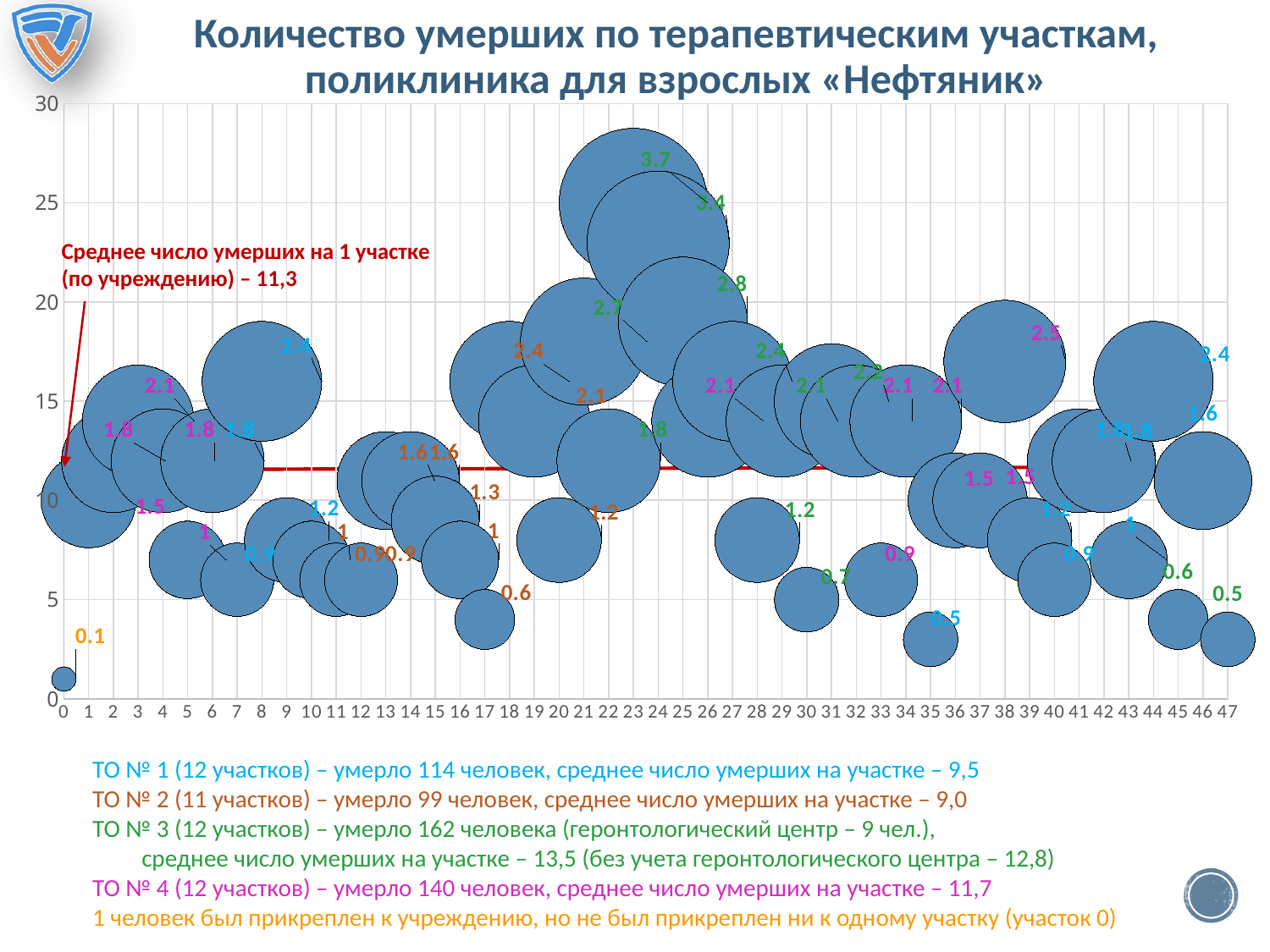
What is the difference between the largest bubble label (3.7) and the smallest bubble label (0.1)? 3.6 What is the highest value shown on the y axis? 30 What is the highest участок number shown on the x axis? 47 What is the largest bubble label shown on the chart? 3.7 Is the value for участок 0 greater or less than 5? less What is the smallest bubble label shown on the chart? 0.1 What is the label on the bubble at участок 0? 0.1 What kind of chart is shown on the slide? bubble chart Is the value for the bubble labelled 3.7 greater or less than 20? greater What is the label on the bubble at участок 47? 0.5 What is the average number of deaths per участок for the institution, as marked by the red line on the chart? 11,3 Which bubble label is larger, 3.7 or 3.4? 3.7